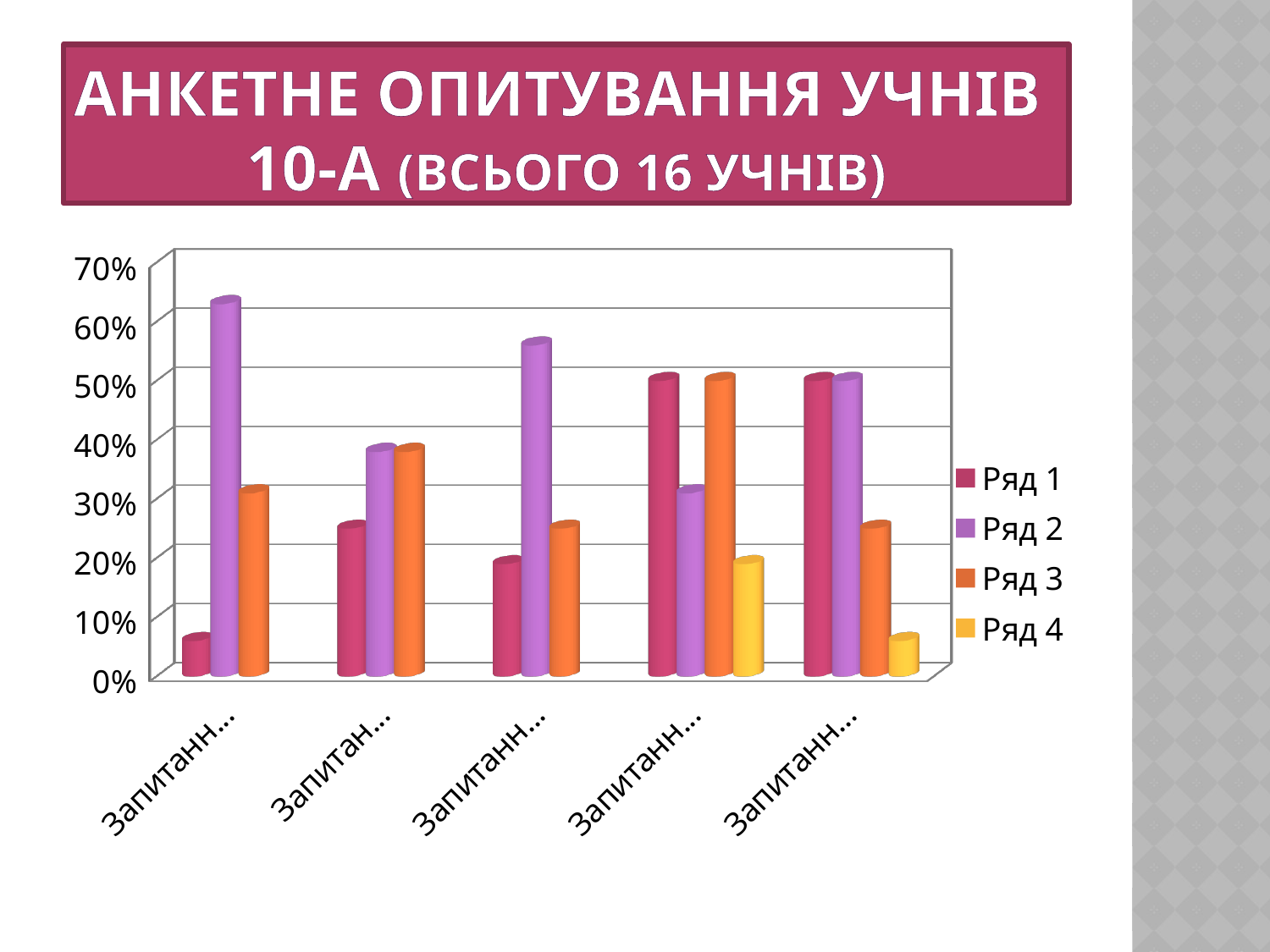
Is the value for Ряд 1 in the first category group greater or less than 10%? less Is the value for Ряд 4 in the fifth category group greater or less than 10%? less How many series does the legend list? 4 How many bars are shown in the fourth category group? 4 In the fourth category group, which is larger: Ряд 1 or Ряд 2? Ряд 1 Is the value for Ряд 2 in the third category group greater or less than 50%? greater Which series has the shortest bar in the first category group? Ряд 1 How many category groups are plotted along the x axis? 5 What kind of chart is shown on the slide? bar chart Which series has the tallest bar in the first category group? Ряд 2 What are the legend entries of the chart? Ряд 1, Ряд 2, Ряд 3, Ряд 4